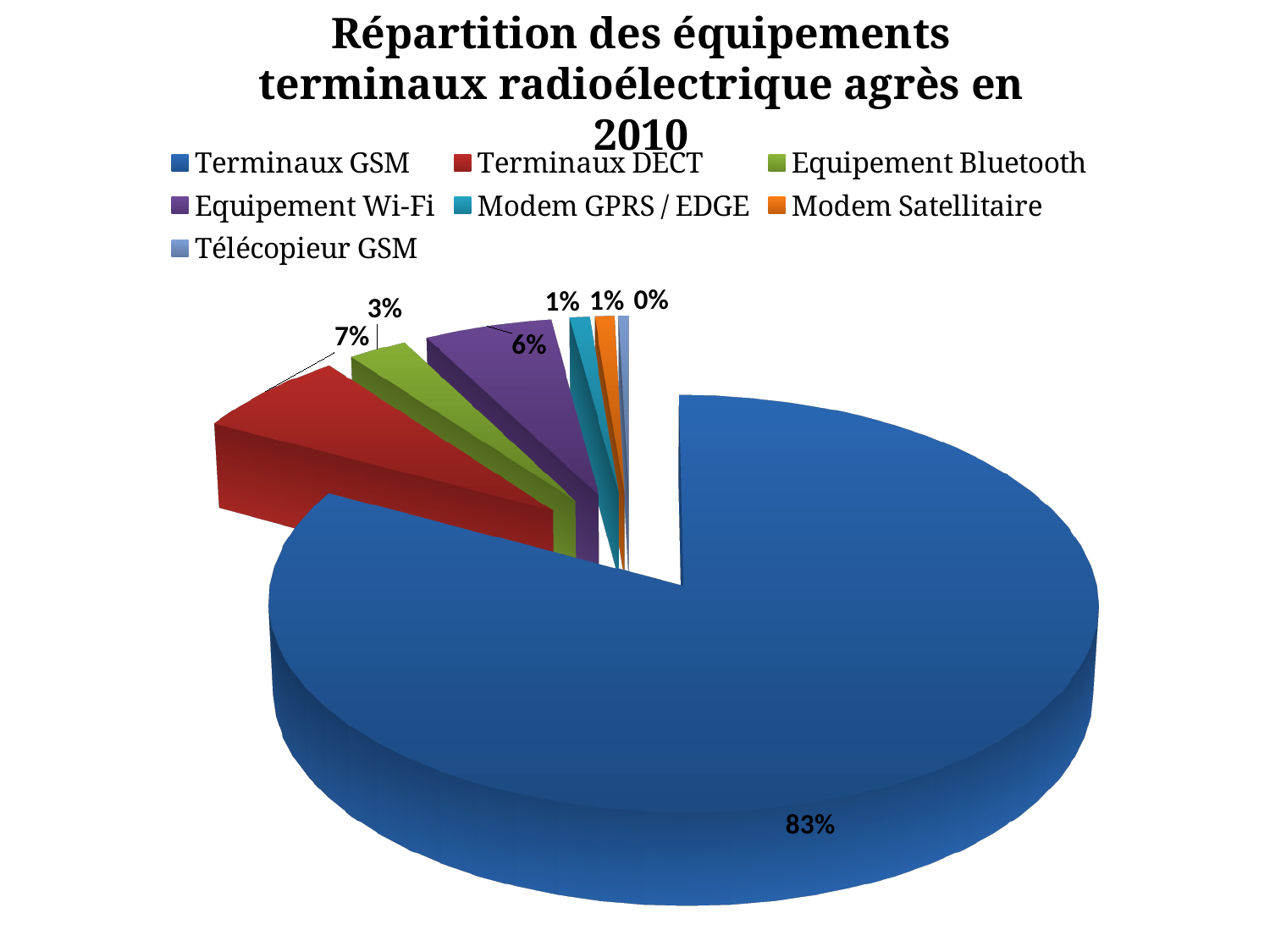
What share of the pie does Terminaux DECT represent? 7% Which category has the largest share of the pie? Terminaux GSM What share of the pie does Equipement Wi-Fi represent? 6% What type of chart is shown on the slide? Pie chart Which category has the smallest share of the pie? Télécopieur GSM What share of the pie does Télécopieur GSM represent? 0% Which has a larger share, Terminaux DECT or Equipement Wi-Fi? Terminaux DECT How many categories does the legend list? 7 What colour is the slice for Modem Satellitaire? Orange What is the difference in share between Terminaux GSM and Terminaux DECT? 76%